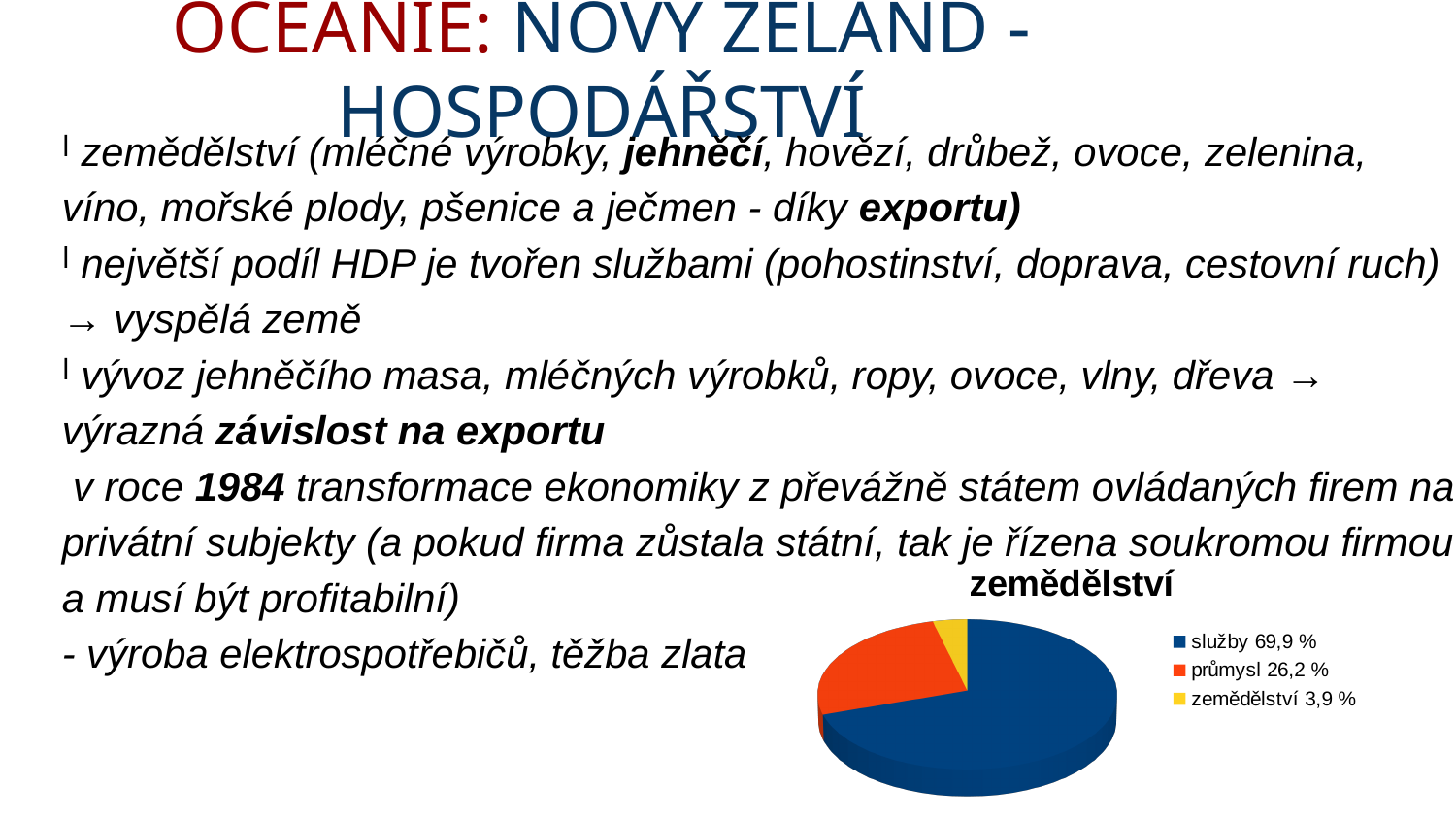
What is the value shown for zemědělství in the pie chart? 3,9 % What is the difference between the values for služby and průmysl in the pie chart? 43,7 % How many categories does the pie chart show? 3 What kind of chart is shown on the slide? pie chart What colour is the slice for průmysl in the pie chart? red Which category has the largest slice of the pie chart? služby What is the difference between the values for průmysl and zemědělství in the pie chart? 22,3 % What is the value shown for služby in the pie chart? 69,9 % Which category has the smallest slice of the pie chart? zemědělství What is the title printed above the pie chart? zemědělství Which is larger in the pie chart, průmysl or zemědělství? průmysl What is the value shown for průmysl in the pie chart? 26,2 %